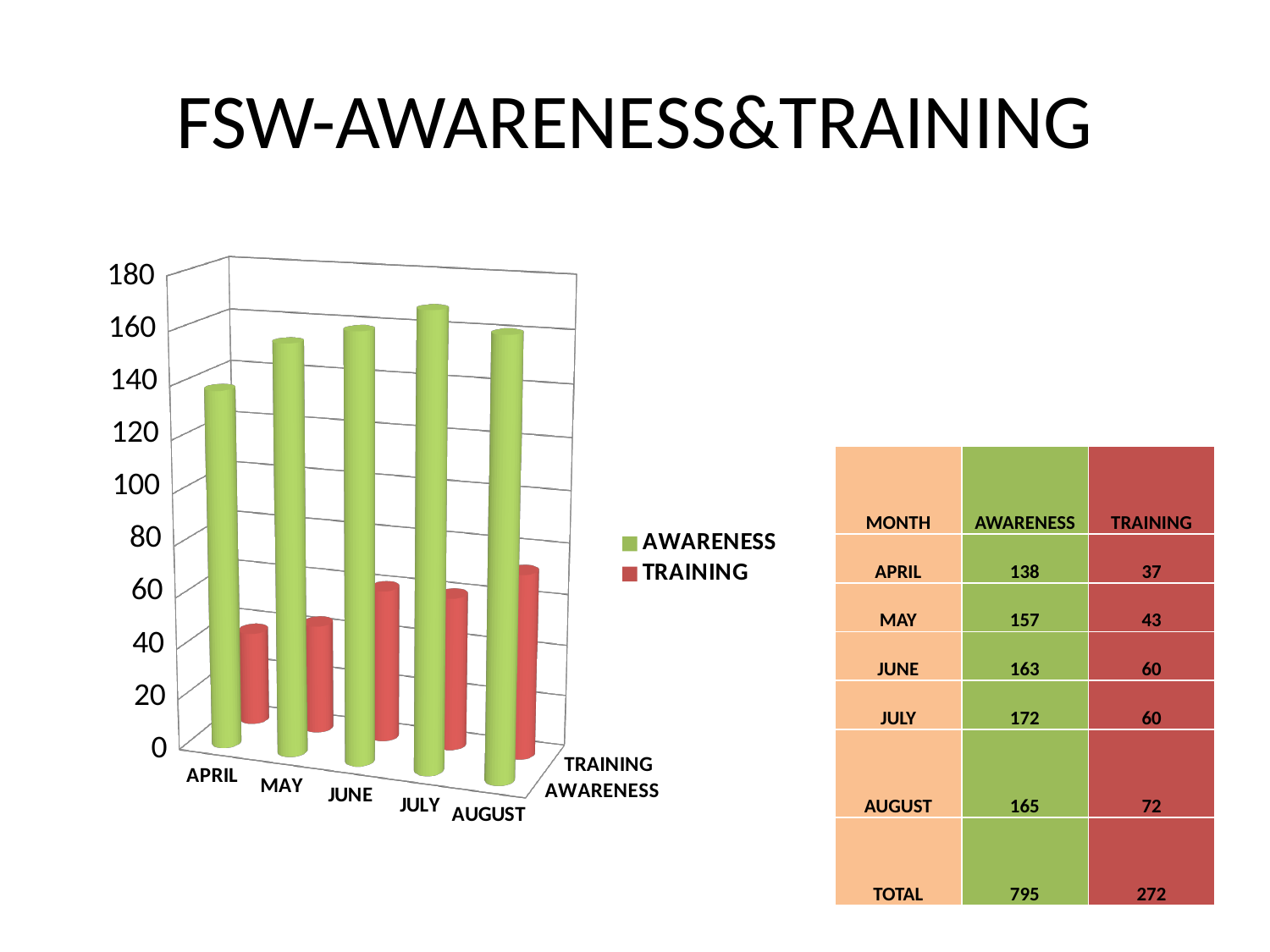
According to the table on the slide, what is the AWARENESS value for MAY? 157 What kind of chart is shown on the slide? bar chart Is the AWARENESS value for APRIL greater or less than 120? greater Is the TRAINING value for MAY greater or less than 60? less Which month has the highest AWARENESS value? JULY According to the table on the slide, what is the TRAINING value for AUGUST? 72 Which month has the lowest AWARENESS value? APRIL Which month has the lowest TRAINING value? APRIL Using the values in the table, what is the difference between the AWARENESS values for JULY and APRIL? 34 How many series does the chart legend list? 2 How many months are plotted along the x axis of the chart? 5 Which month has the highest TRAINING value? AUGUST